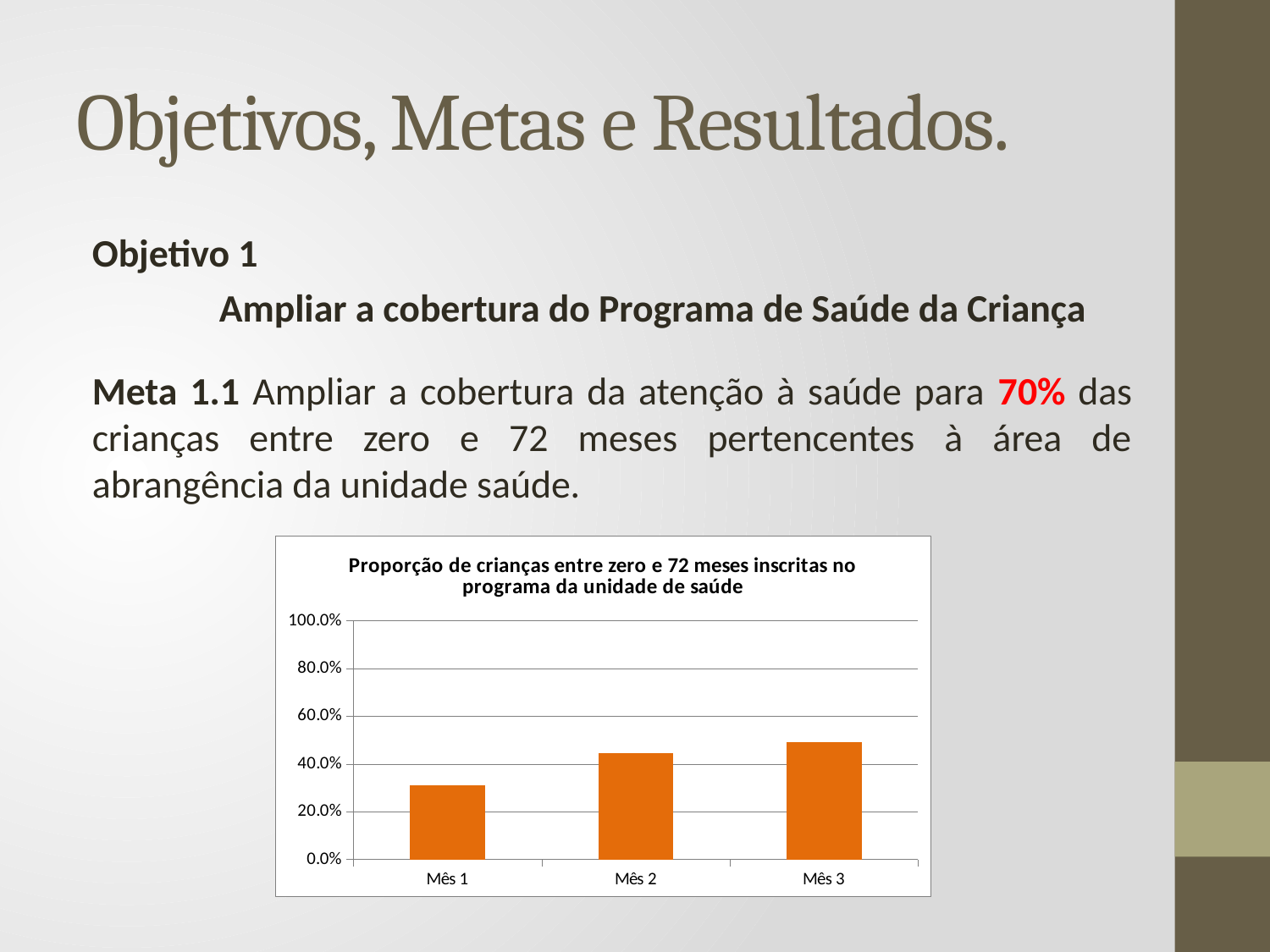
Do the values rise or fall from Mês 1 to Mês 3? rise Which month has the lowest proportion of children enrolled? Mês 1 Which month has the highest proportion of children enrolled? Mês 3 Is the value for Mês 3 greater or less than 60.0%? less Is the value for Mês 2 greater or less than 40.0%? greater What kind of chart is shown on the slide? bar chart How many categories (months) are plotted on the chart? 3 What is the title of the chart? Proporção de crianças entre zero e 72 meses inscritas no programa da unidade de saúde Is the value for Mês 1 greater or less than 20.0%? greater Which is larger, the value for Mês 1 or the value for Mês 2? Mês 2 Which is larger, the value for Mês 2 or the value for Mês 3? Mês 3